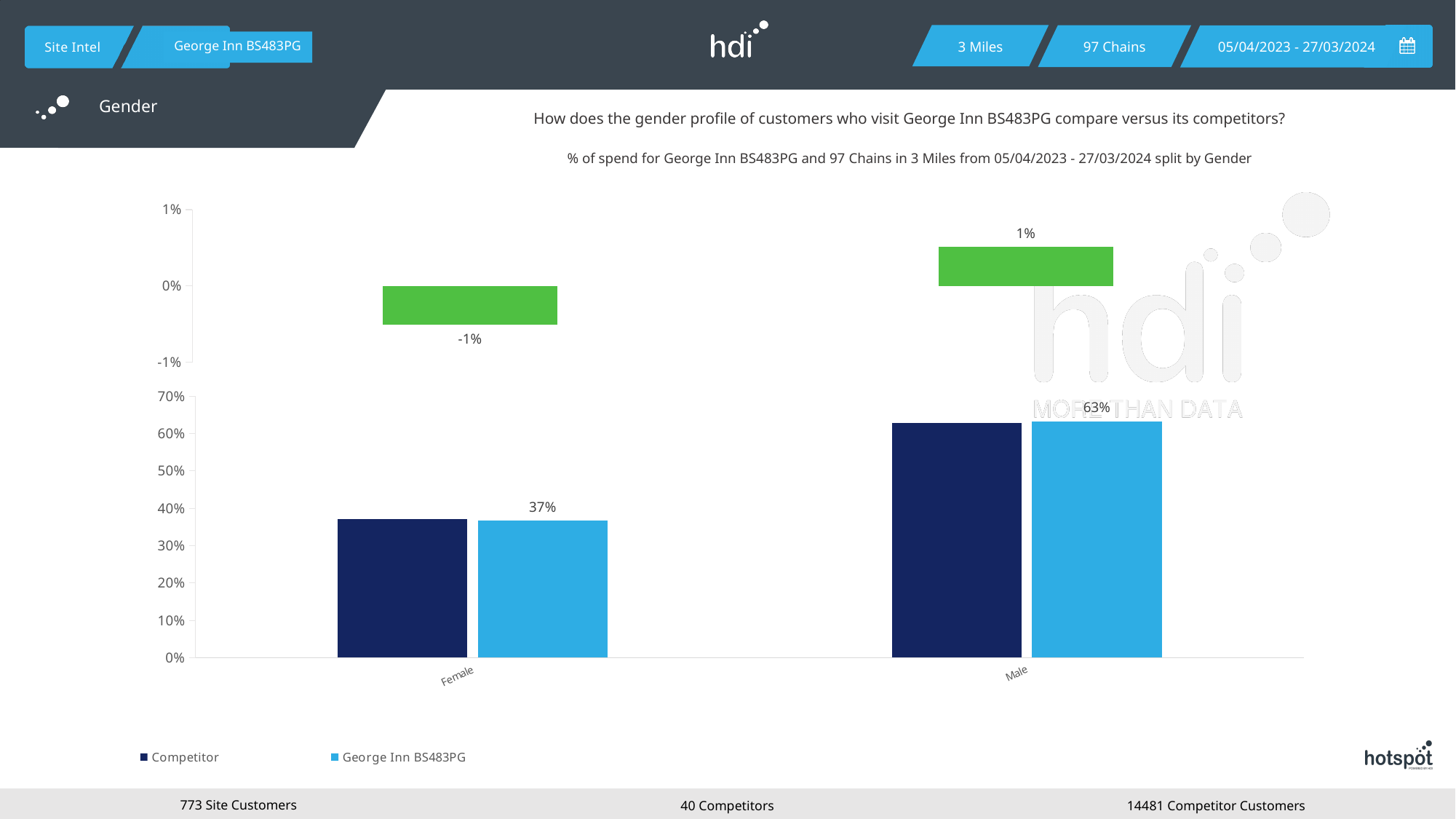
In the top chart, what is the value shown for the Male category? 1% How many series does the legend of the bottom chart list? 2 How many categories are shown on the x axis of the bottom chart? 2 In the bottom chart, which category has the lowest value for George Inn BS483PG? Female In the top chart, what is the value shown for the Female category? -1% In the bottom chart, is the Competitor value for Male greater or less than 50%? greater In the bottom chart, is the Competitor value for Female greater or less than 40%? less In the bottom chart, which category has the highest value for George Inn BS483PG? Male In the bottom chart, what is the value for George Inn BS483PG in the Male category? 63% What kind of chart is the bottom chart? Bar chart In the bottom chart, what is the value for George Inn BS483PG in the Female category? 37% In the bottom chart, what is the difference between the George Inn BS483PG values for Male and Female? 26%